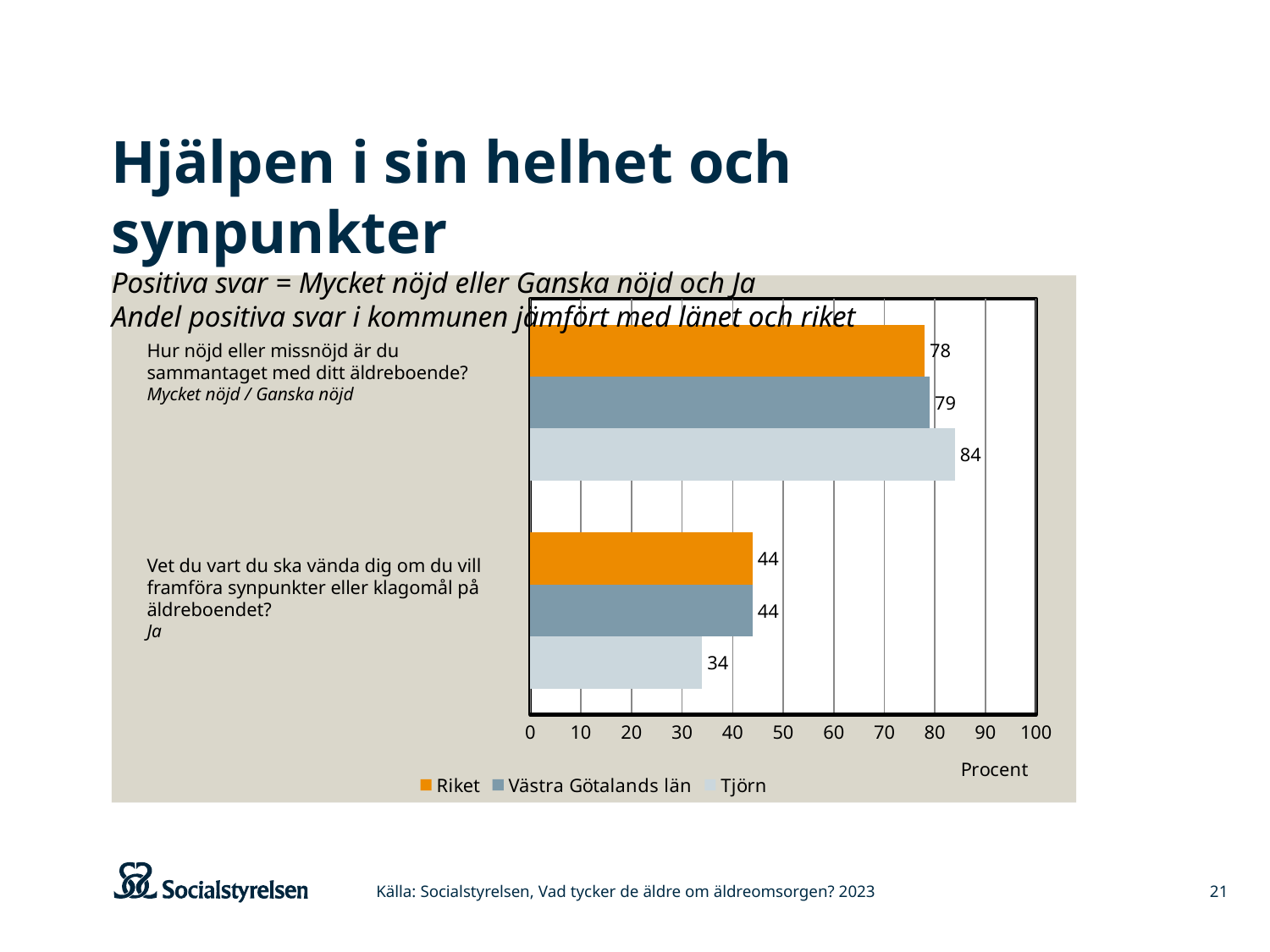
What is the label on the horizontal axis of the chart? Procent What kind of chart is shown on the slide? Bar chart What is the value for Västra Götalands län on the question "Hur nöjd eller missnöjd är du sammantaget med ditt äldreboende?"? 79 How many series does the legend list? 3 What is the difference between the Riket value and the Tjörn value on the question "Vet du vart du ska vända dig om du vill framföra synpunkter eller klagomål på äldreboendet?"? 10 What is the difference between the Tjörn value and the Riket value on the question "Hur nöjd eller missnöjd är du sammantaget med ditt äldreboende?"? 6 What is the value for Riket on the question "Vet du vart du ska vända dig om du vill framföra synpunkter eller klagomål på äldreboendet?"? 44 Which series has the lowest value on the question "Vet du vart du ska vända dig om du vill framföra synpunkter eller klagomål på äldreboendet?"? Tjörn Which is larger for Tjörn: the value for "Hur nöjd eller missnöjd är du sammantaget med ditt äldreboende?" or the value for "Vet du vart du ska vända dig om du vill framföra synpunkter eller klagomål på äldreboendet?"? Hur nöjd eller missnöjd är du sammantaget med ditt äldreboende? What is the value for Tjörn on the question "Hur nöjd eller missnöjd är du sammantaget med ditt äldreboende?"? 84 Which series has the highest value on the question "Hur nöjd eller missnöjd är du sammantaget med ditt äldreboende?"? Tjörn What is the value for Tjörn on the question "Vet du vart du ska vända dig om du vill framföra synpunkter eller klagomål på äldreboendet?"? 34